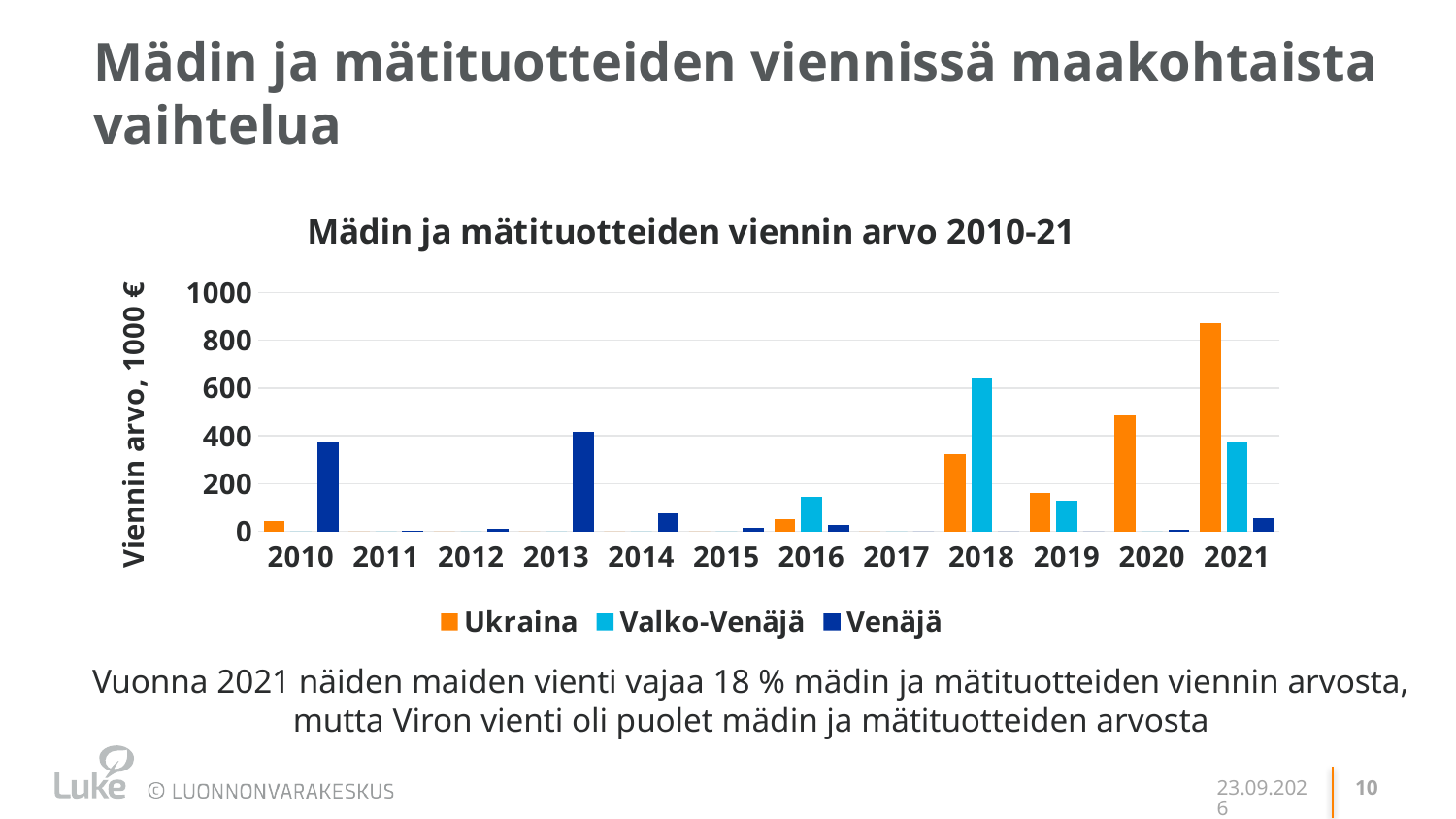
What is the title of the y axis? Viennin arvo, 1000 € In 2018, which is larger: the value for Ukraina or for Valko-Venäjä? Valko-Venäjä In which year is the value for Venäjä highest? 2013 In which year is the value for Ukraina highest? 2021 How many years are shown on the x axis? 12 How many series does the legend list? 3 Is the value for Ukraina in 2020 greater or less than 400? greater Is the value for Ukraina in 2021 greater or less than 800? greater What kind of chart is shown on the slide? bar chart Is the value for Valko-Venäjä in 2018 greater or less than 600? greater In 2021, which is larger: the value for Ukraina or for Valko-Venäjä? Ukraina